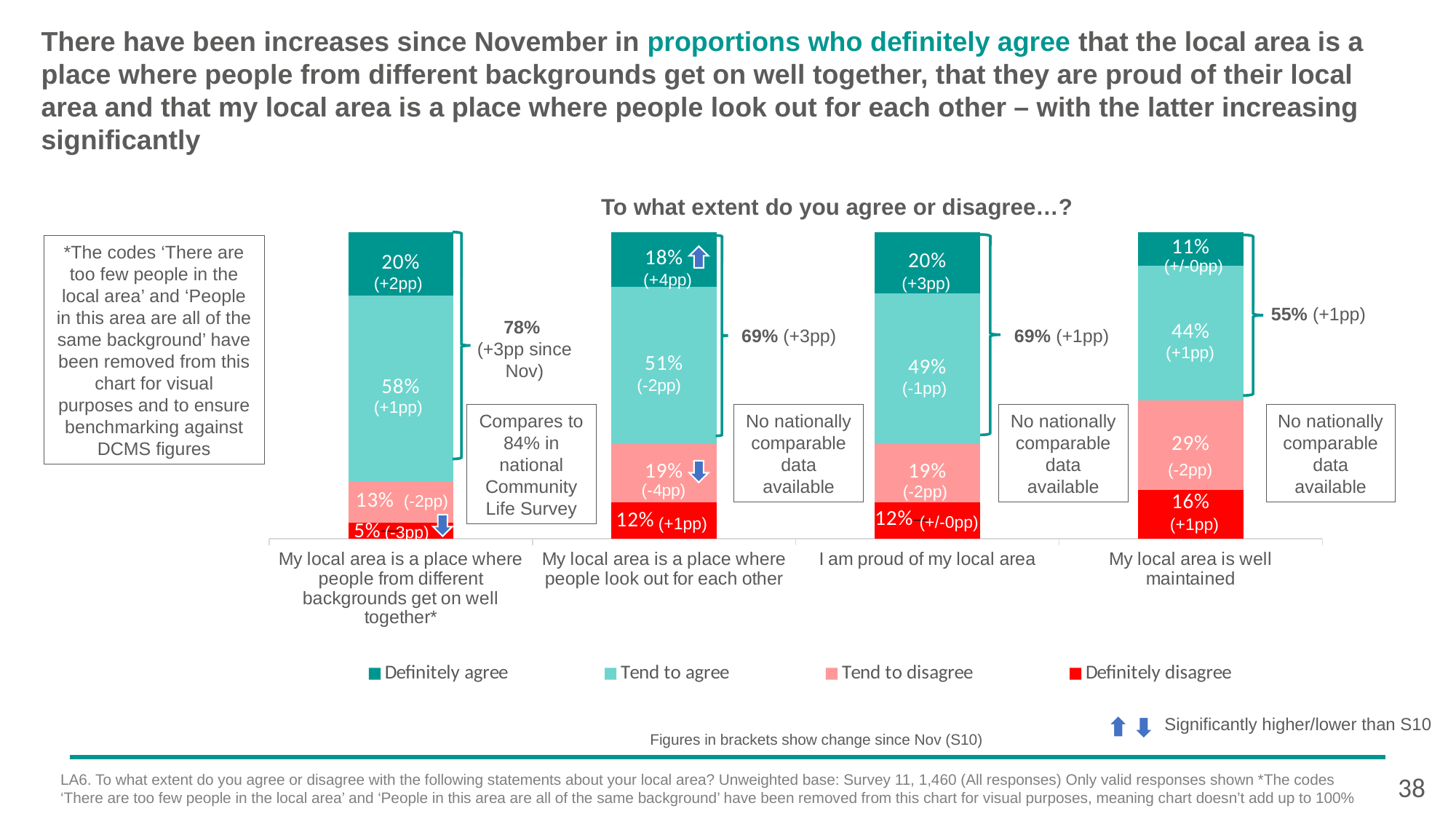
How many statements are shown on the x axis of the chart? 4 What is the difference in 'Definitely disagree' percentage between 'My local area is well maintained' and 'My local area is a place where people from different backgrounds get on well together'? 11pp What is the total of the four segments in the bar for 'I am proud of my local area'? 100% What percentage definitely agree that 'My local area is a place where people look out for each other'? 18% What is the combined agree figure shown for 'My local area is a place where people from different backgrounds get on well together'? 78% What kind of chart is shown on the slide? Stacked bar chart Which statement has the lowest 'Definitely agree' percentage? My local area is well maintained What is the title of the chart? To what extent do you agree or disagree…? What percentage tend to disagree that 'My local area is well maintained'? 29% Which statement has the highest 'Tend to agree' percentage? My local area is a place where people from different backgrounds get on well together Which has a larger 'Tend to agree' percentage: 'I am proud of my local area' or 'My local area is well maintained'? I am proud of my local area How many series does the chart legend list? 4